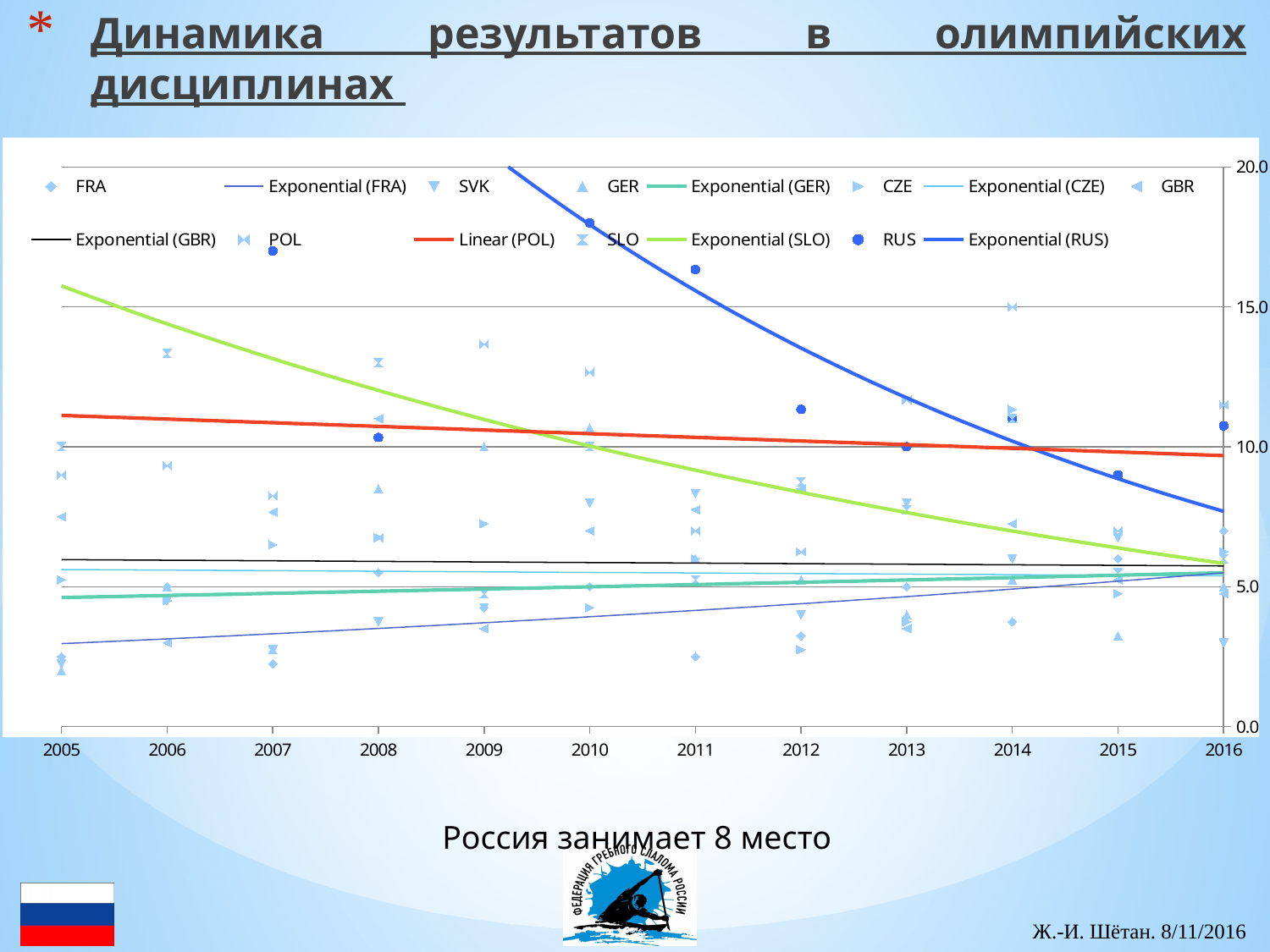
How many entries does the chart legend list? 15 Does the Exponential (RUS) trendline rise or fall from 2005 to 2016? fall Is the value for RUS in 2011 greater or less than 15.0? greater What colour is the Linear (POL) trendline in the chart? red Is the value for RUS in 2015 greater or less than 10.0? less How many countries are plotted as data series in the chart? 8 What is the first year shown on the x axis of the chart? 2005 What kind of chart is shown on the slide? scatter chart Is the value for RUS in 2010 greater or less than 15.0? greater Does the Exponential (SLO) trendline rise or fall from 2005 to 2016? fall How many years are shown along the x axis of the chart? 12 Does the Exponential (FRA) trendline rise or fall from 2005 to 2016? rise